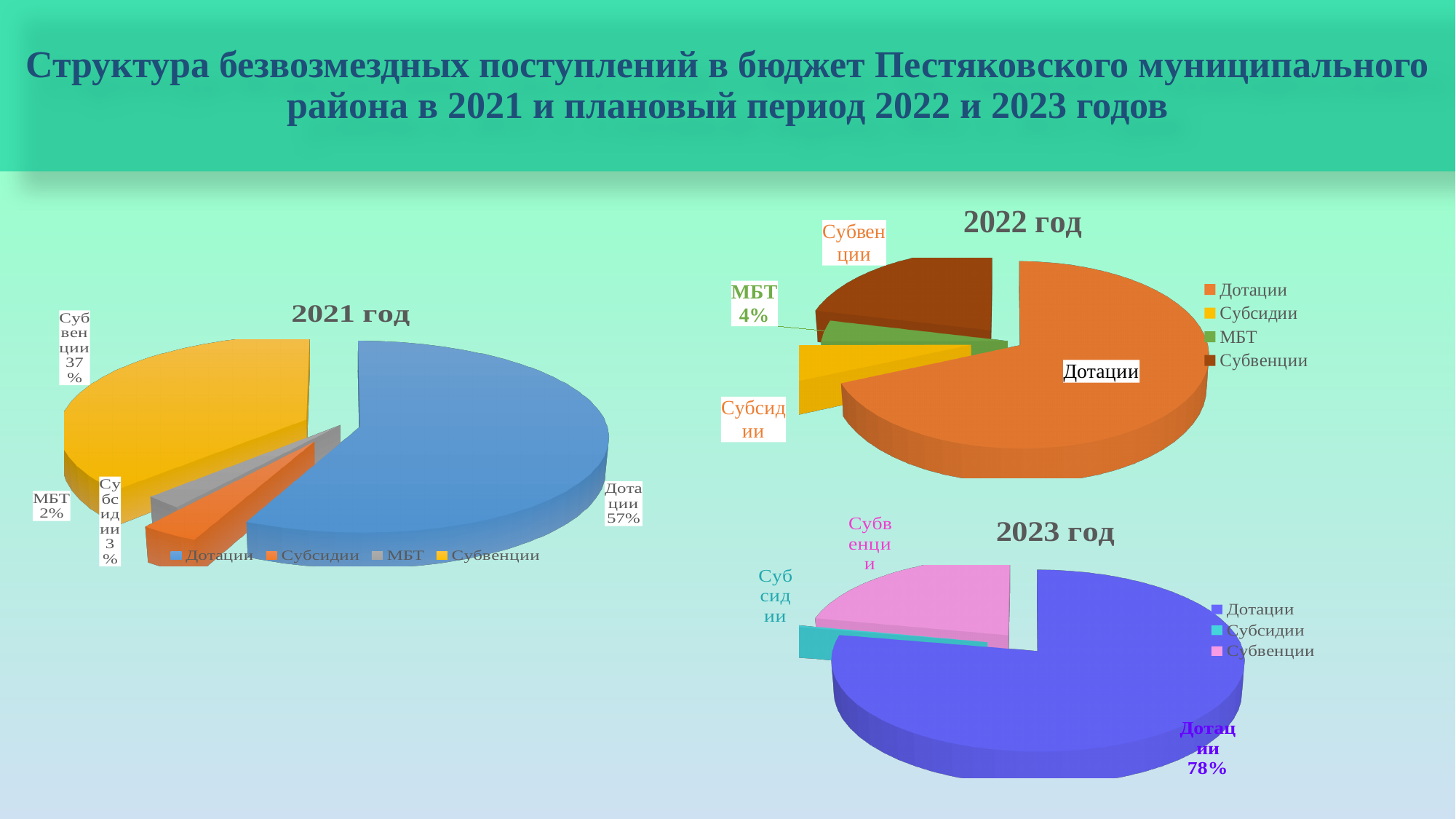
In the 2023 год chart, what share is shown for Дотации? 78% In the 2022 год chart, which category has the largest slice? Дотации In the 2022 год chart, what share is shown for МБТ? 4% In the 2021 год chart, what share is shown for Субсидии? 3% How many entries does the legend of the 2023 год chart list? 3 In the 2021 год chart, what share is shown for МБТ? 2% In the 2021 год chart, what is the difference in percentage points between Дотации and Субвенции? 20 In the 2021 год chart, what share is shown for Субвенции? 37% In the 2021 год chart, what share is shown for Дотации? 57% In the 2021 год chart, which category has the smallest slice? МБТ What type of chart is the 2022 год chart? Pie chart In the 2021 год chart, which category has the largest slice? Дотации